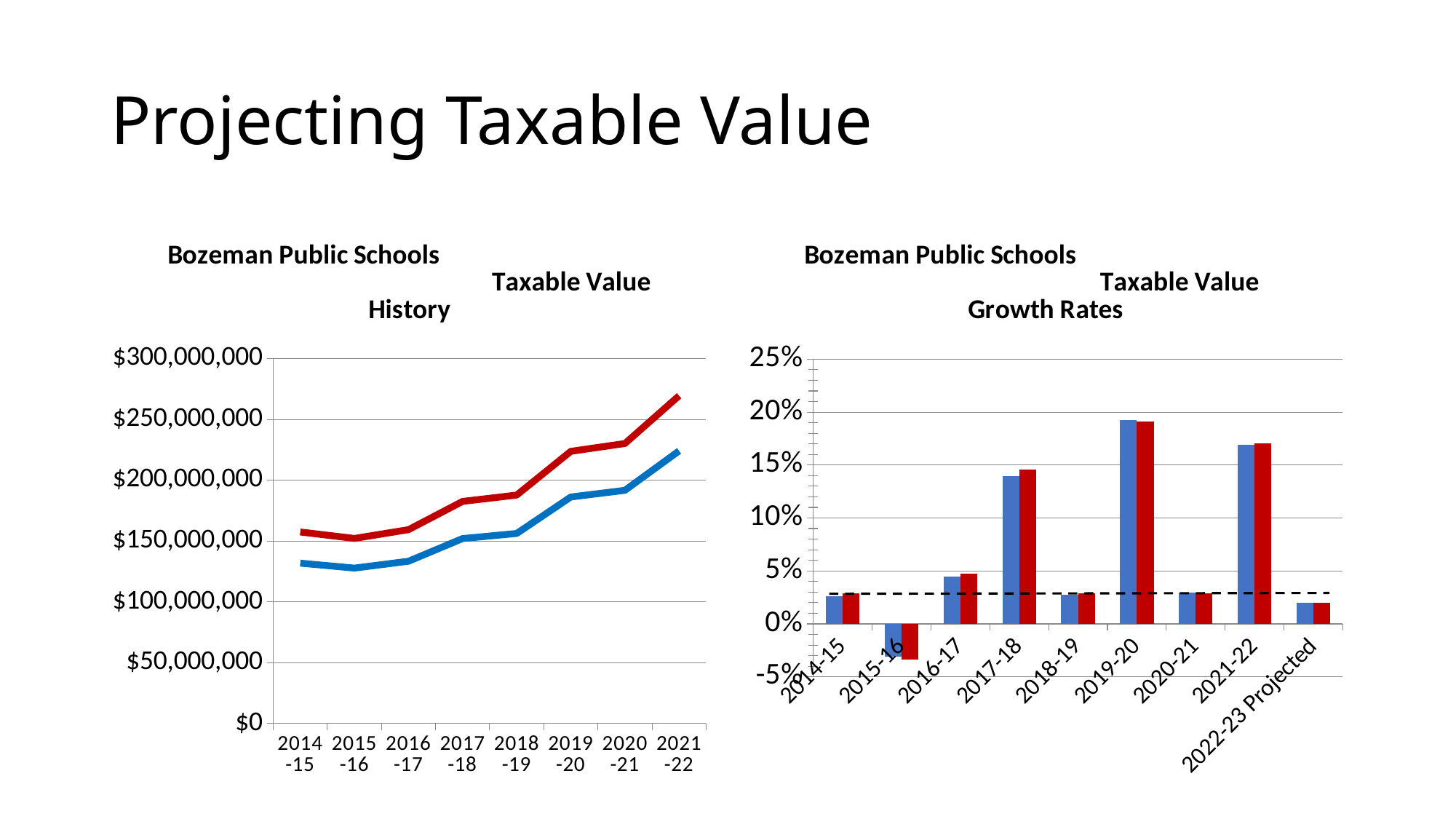
In the 'Taxable Value Growth Rates' chart on the right, which school year has the highest growth rate? 2019-20 What kind of chart is the 'Bozeman Public Schools Taxable Value History' chart on the left? line chart In the 'Taxable Value Growth Rates' chart on the right, is the blue bar for 2017-18 greater or less than 10%? greater In the 'Taxable Value Growth Rates' chart on the right, which school year has the lowest growth rate? 2015-16 In the 'Taxable Value History' chart on the left, is the blue line's value for 2014-15 greater or less than $150,000,000? less How many school years are shown on the x axis of the 'Taxable Value History' chart on the left? 8 How many school years are shown on the x axis of the 'Taxable Value Growth Rates' chart on the right? 9 In the 'Taxable Value History' chart on the left, is the red line's value for 2021-22 greater or less than $250,000,000? greater What kind of chart is the 'Bozeman Public Schools Taxable Value Growth Rates' chart on the right? bar chart In the 'Taxable Value History' chart on the left, which line is higher in 2021-22, the red line or the blue line? the red line In the 'Taxable Value History' chart on the left, do the values generally rise or fall from 2014-15 to 2021-22? rise